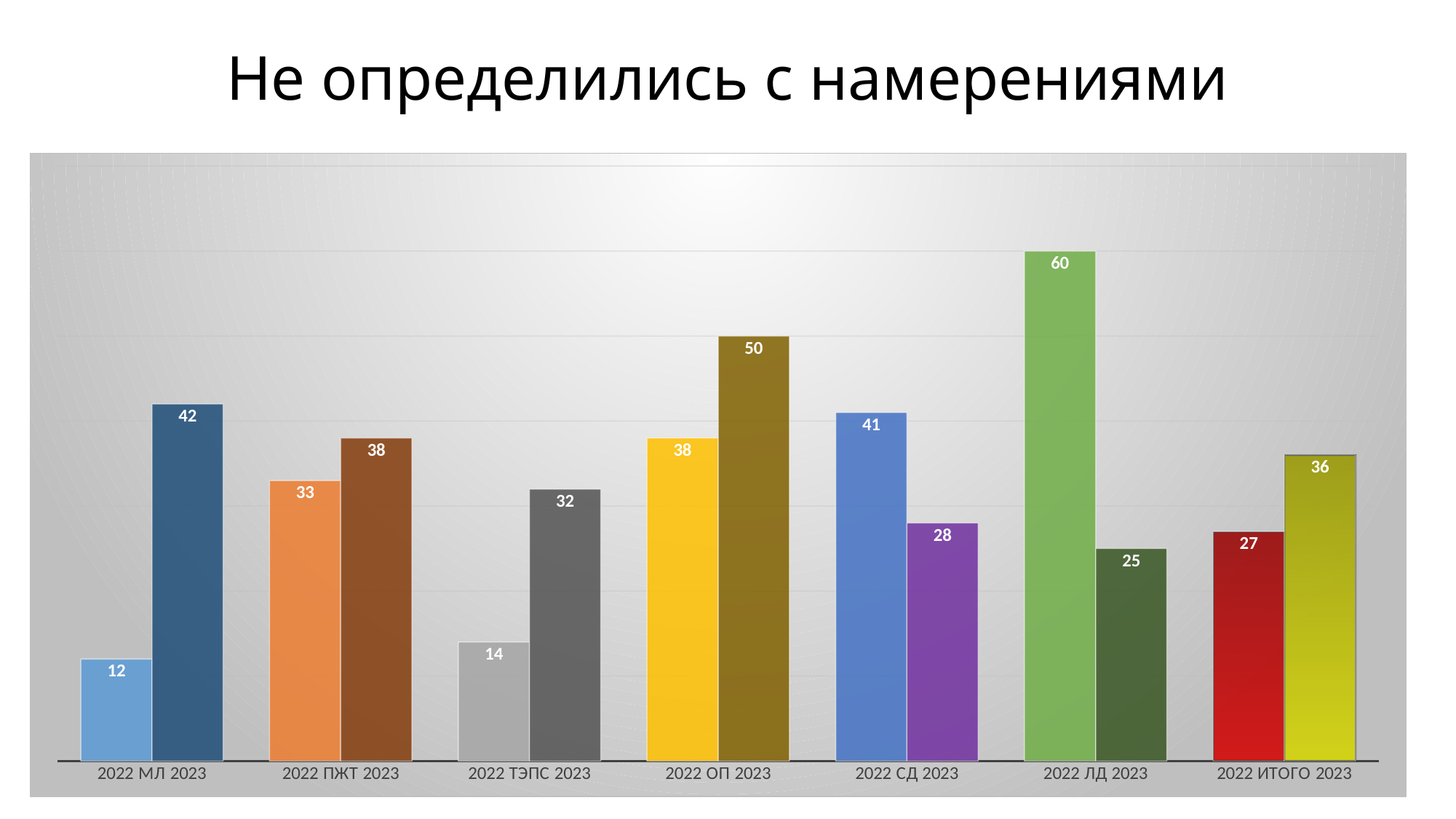
What is the value for ЛД in 2022? 60 What is the title of the slide? Не определились с намерениями What is the value for МЛ in 2023? 42 How many category groups are shown on the x axis? 7 What is the value for ТЭПС in 2022? 14 What kind of chart is shown on the slide? Bar chart Which bar has the lowest value on the chart? МЛ 2022 (12) Which is larger for СД: the 2022 value or the 2023 value? 2022 (41) What is the value for ИТОГО in 2023? 36 What is the difference between the 2022 and 2023 values for ЛД? 35 What is the difference between the 2023 and 2022 values for МЛ? 30 Which bar has the highest value on the chart? ЛД 2022 (60)